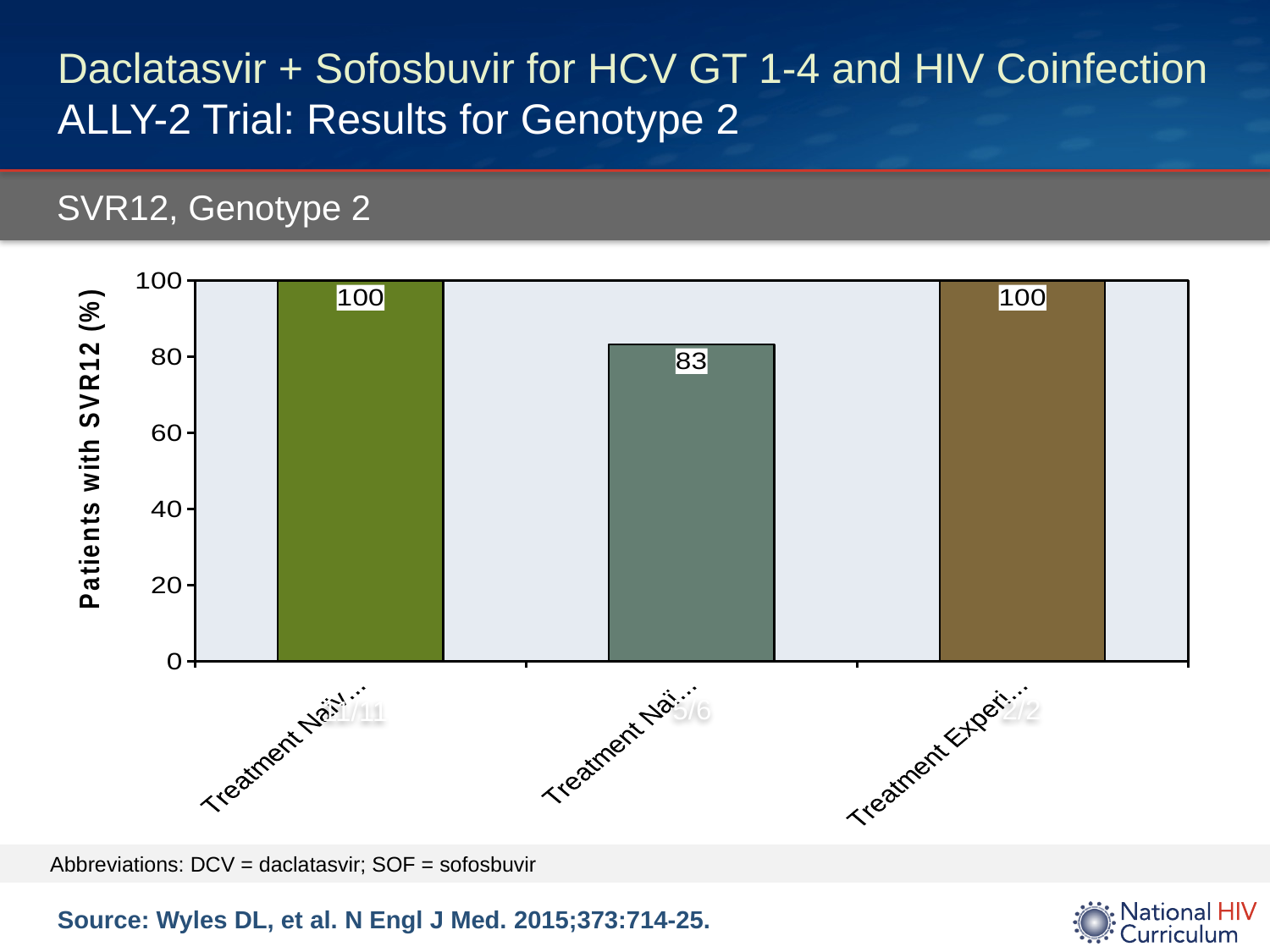
What kind of chart is shown on the slide? Bar chart Which bar has the lowest value? The middle bar How many bars are plotted in the chart? 3 What is the value of the middle bar in the chart? 83 What is the value of the leftmost bar in the chart? 100 What is the y-axis title of the chart? Patients with SVR12 (%) Which is larger, the value of the leftmost bar or the middle bar? The leftmost bar Is the value of the middle bar greater or less than 80? greater What is the value of the bar labelled "Treatment Experi..." (the rightmost bar)? 100 What is the highest value shown in the chart? 100 What is the difference between the value of the leftmost bar and the middle bar? 17 What is the title shown above the chart? SVR12, Genotype 2